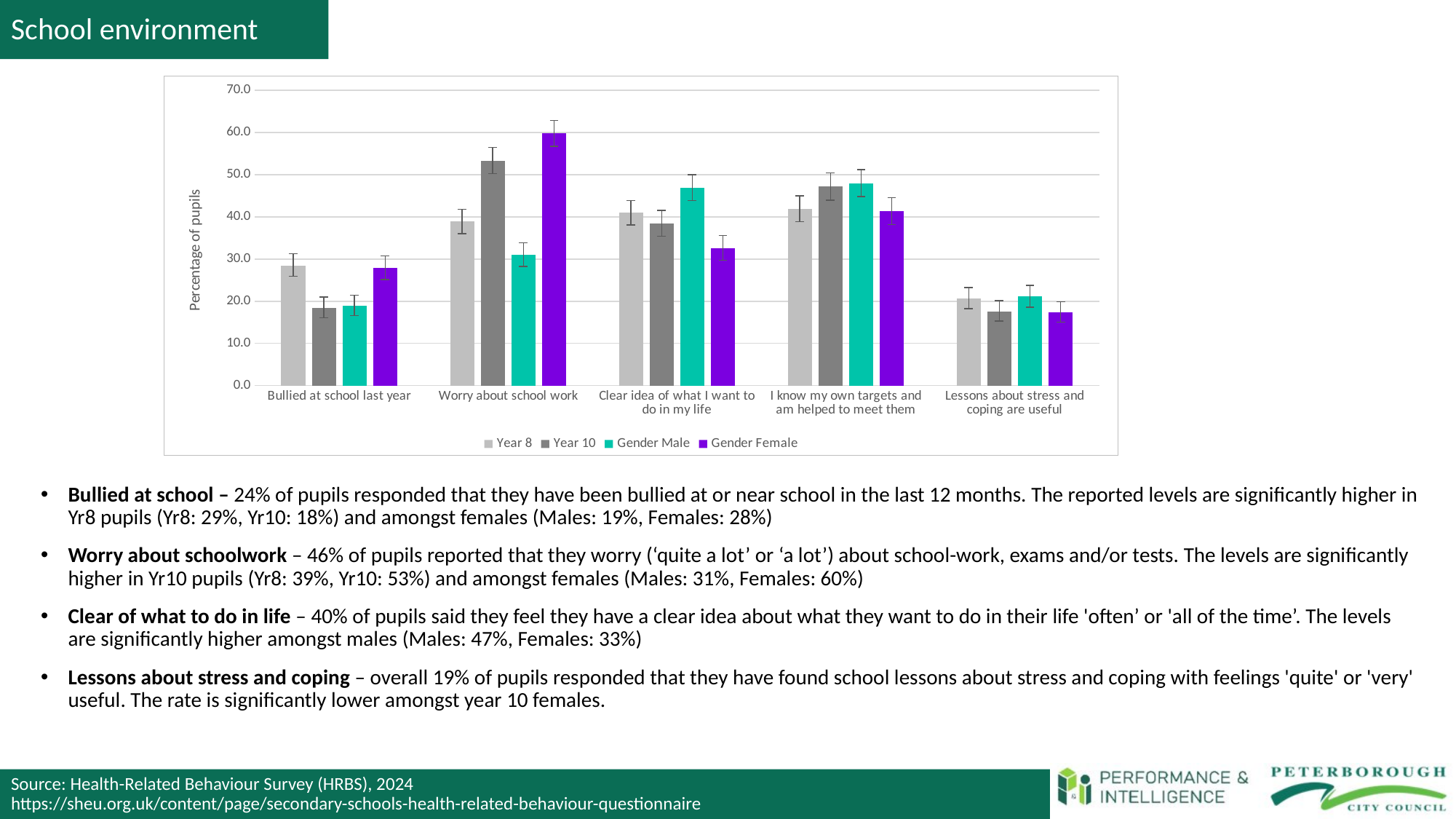
For 'Worry about school work', which is larger: the Year 8 bar or the Year 10 bar? Year 10 Which series has the highest bar in the 'Worry about school work' category? Gender Female Which series has the lowest bar in the 'Worry about school work' category? Gender Male Is the Year 8 value for 'Bullied at school last year' greater or less than 30.0? less What kind of chart is shown on the slide? bar chart Which series has the highest bar in the 'Bullied at school last year' category? Year 8 Is the Year 10 value for 'Worry about school work' greater or less than 50.0? greater How many series does the chart legend list? 4 How many categories are shown along the x axis of the chart? 5 Which series has the highest bar in the 'Clear idea of what I want to do in my life' category? Gender Male Is the Gender Female value for 'Clear idea of what I want to do in my life' greater or less than 30.0? greater What is the label on the vertical axis of the chart? Percentage of pupils